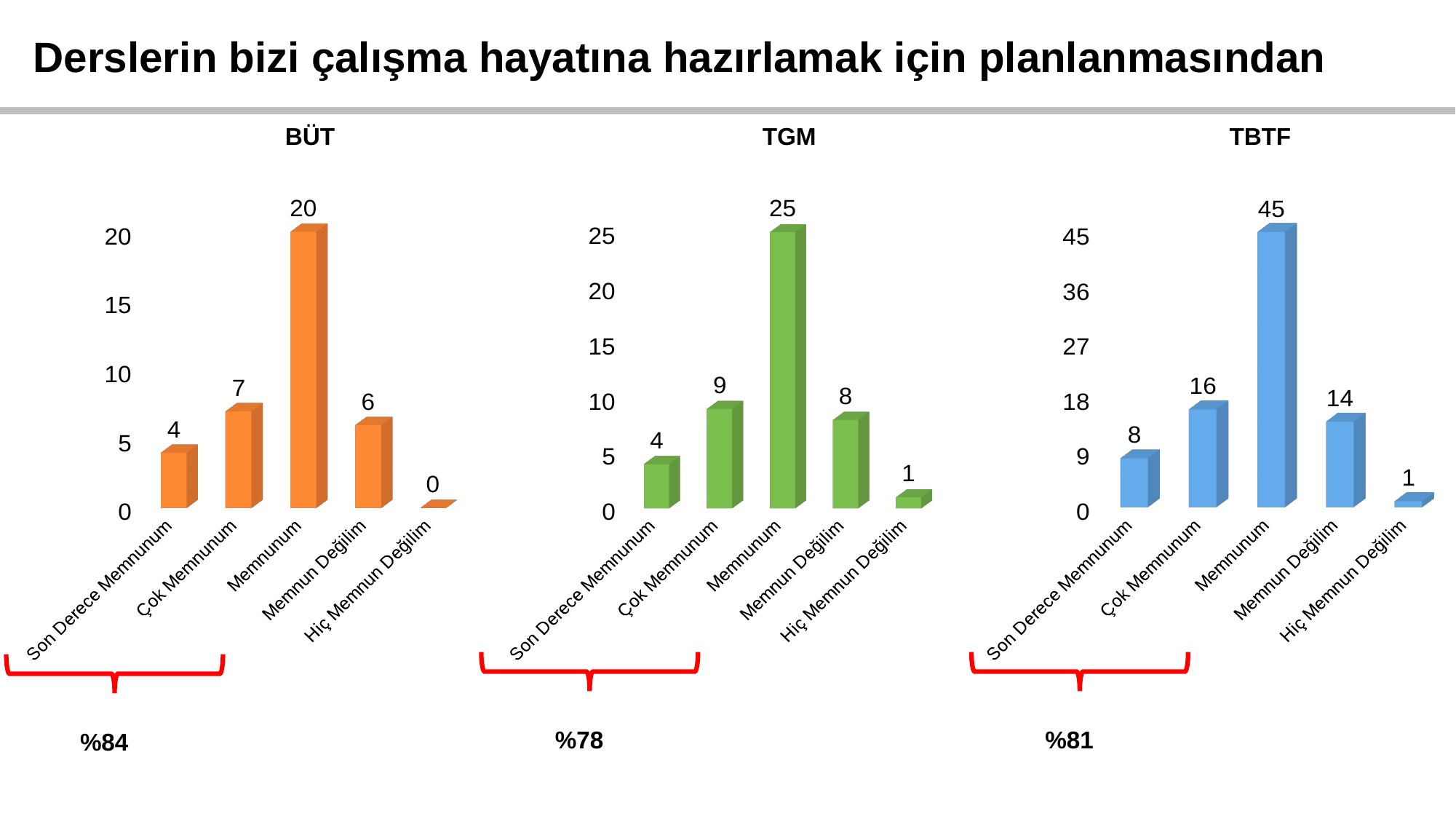
In the TBTF chart, which category has the highest value? Memnunum In the BÜT chart, what is the value for Memnunum? 20 How many categories does the TGM chart show? 5 What colour are the bars in the TBTF chart? blue In the TBTF chart, which is larger: the value for Çok Memnunum or the value for Memnun Değilim? Çok Memnunum In the TGM chart, what is the difference between the values for Memnunum and Memnun Değilim? 17 In the BÜT chart, what is the value for Son Derece Memnunum? 4 In the TGM chart, what is the value for Çok Memnunum? 9 What percentage is shown below the TGM chart? %78 What kind of chart is the BÜT chart? bar chart In the TBTF chart, what is the value for Memnun Değilim? 14 In the BÜT chart, which category has the lowest value? Hiç Memnun Değilim